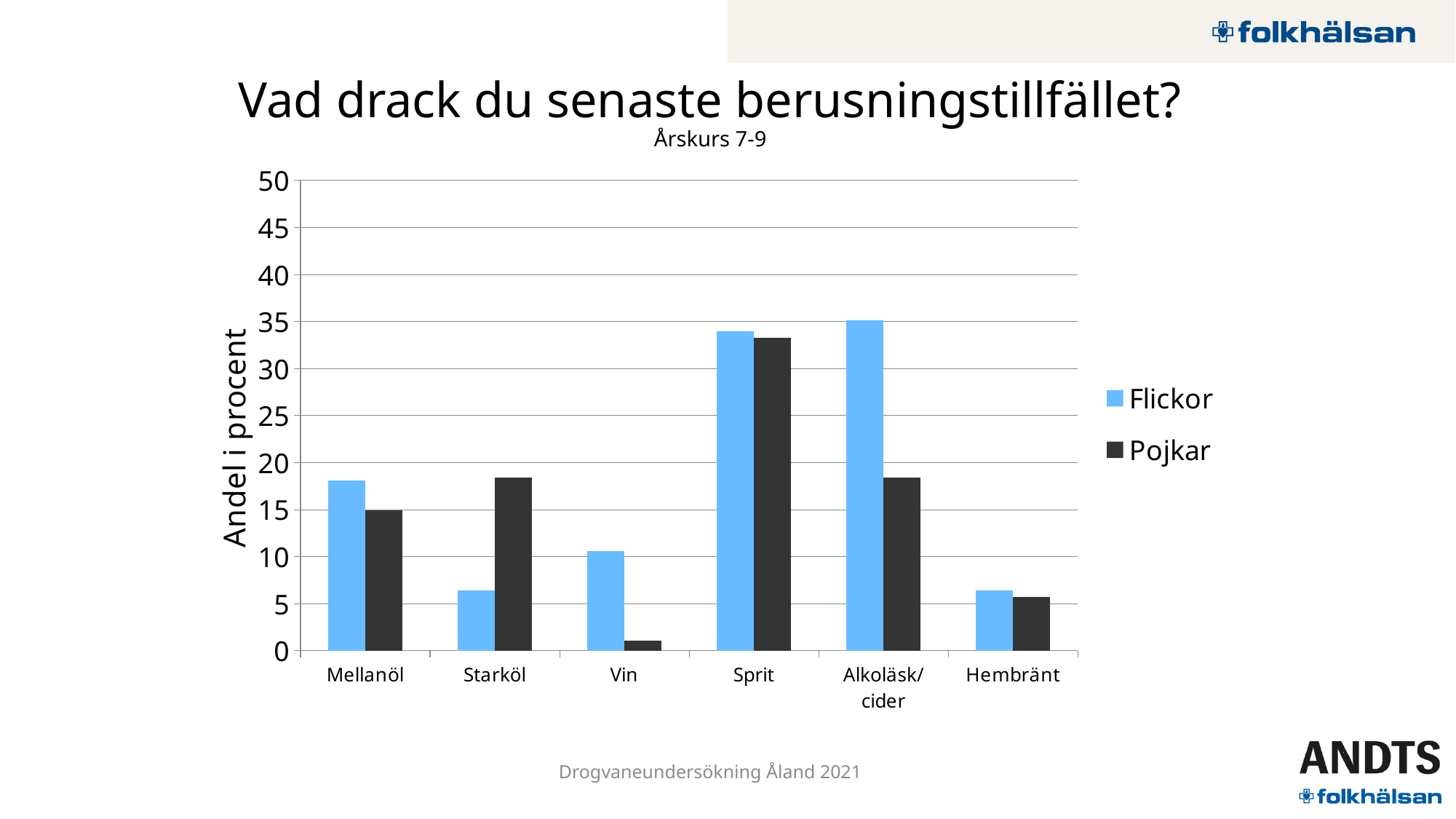
What kind of chart is shown on the slide? bar chart Is the value for Pojkar at Vin greater or less than 5? less For Vin, which is larger, Flickor or Pojkar? Flickor For Starköl, which is larger, Flickor or Pojkar? Pojkar How many categories are shown on the x axis? 6 What is the label of the y axis? Andel i procent Which category has the highest value for Flickor? Alkoläsk/cider How many series does the legend list? 2 For Alkoläsk/cider, which is larger, Flickor or Pojkar? Flickor Is the value for Flickor at Sprit greater or less than 30? greater Which category has the highest value for Pojkar? Sprit Which category has the lowest value for Pojkar? Vin